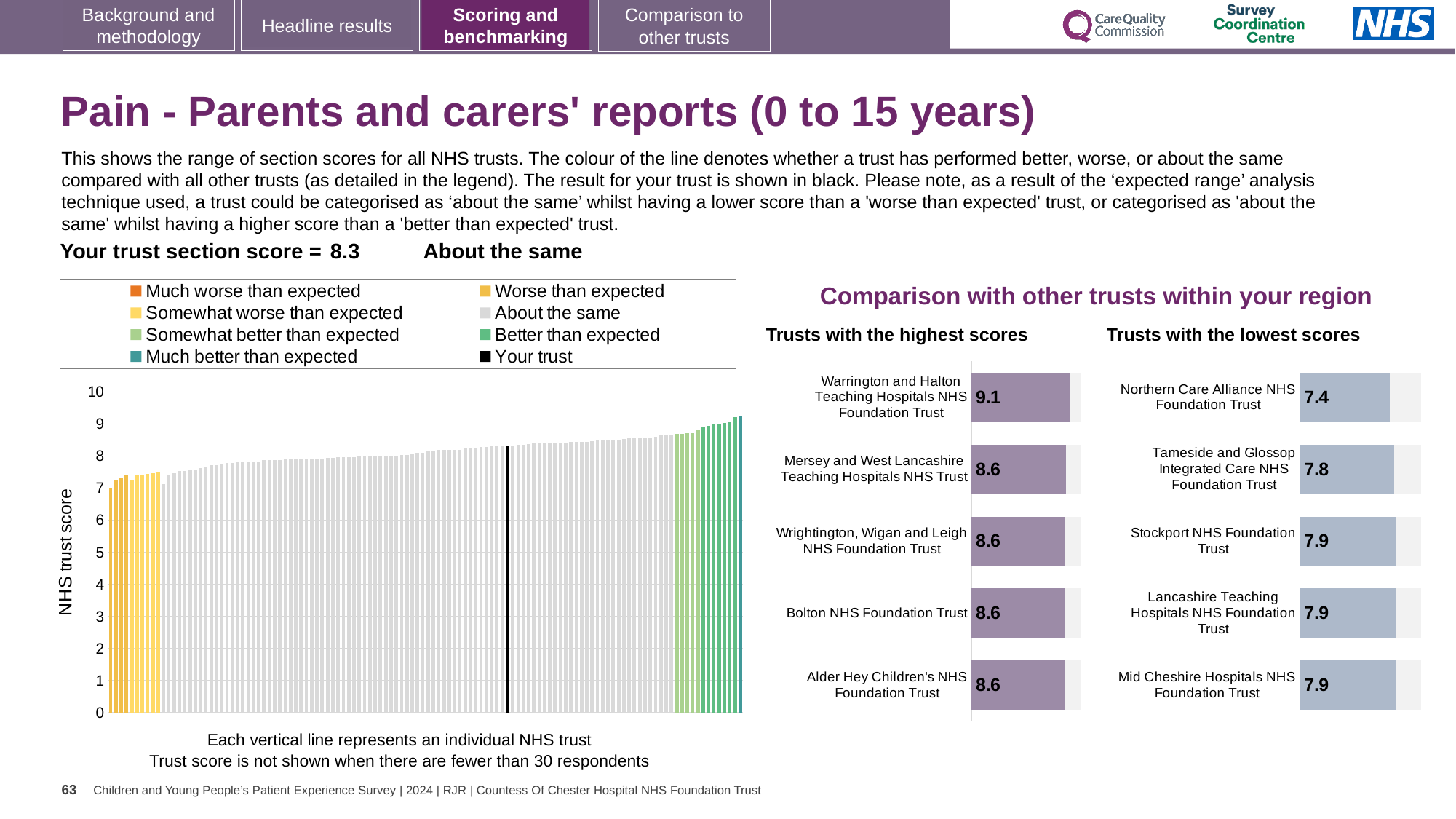
What kind of chart is the large chart on the left with the y-axis labelled 'NHS trust score'? Bar chart How many trusts are listed in the 'Trusts with the highest scores' chart? 5 In the 'Trusts with the lowest scores' chart, what is the score for Northern Care Alliance NHS Foundation Trust? 7.4 How many entries does the legend of the large chart on the left list? 8 In the 'Trusts with the lowest scores' chart, what is the score for Tameside and Glossop Integrated Care NHS Foundation Trust? 7.8 In the 'Trusts with the highest scores' chart, which trust has the highest score? Warrington and Halton Teaching Hospitals NHS Foundation Trust In the 'Trusts with the lowest scores' chart, which has the larger score: Stockport NHS Foundation Trust or Northern Care Alliance NHS Foundation Trust? Stockport NHS Foundation Trust In the 'Trusts with the lowest scores' chart, which trust has the lowest score? Northern Care Alliance NHS Foundation Trust In the 'Trusts with the highest scores' chart, what is the score for Warrington and Halton Teaching Hospitals NHS Foundation Trust? 9.1 In the large chart on the left, is the value of the black bar (your trust) greater or less than 8? greater In the large chart on the left, do the trust scores rise or fall from left to right? Rise In the 'Trusts with the highest scores' chart, what is the difference between the scores of Warrington and Halton Teaching Hospitals NHS Foundation Trust and Bolton NHS Foundation Trust? 0.5